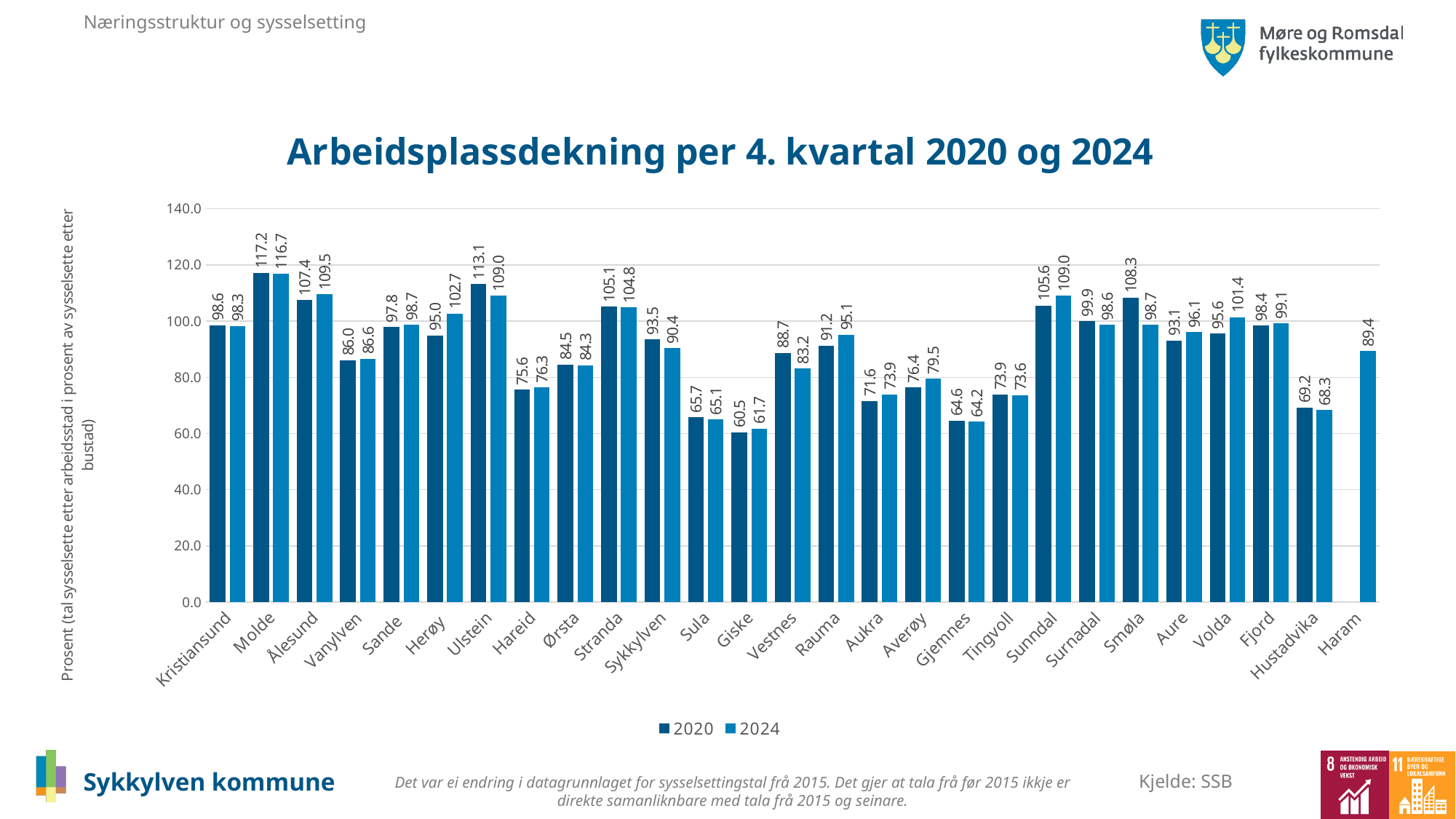
Which municipality has the highest value in 2020? Molde By how much did the value for Smøla fall from 2020 to 2024? 9.6 What type of chart is shown on the slide? Bar chart Which is larger for Volda: the 2020 value or the 2024 value? 2024 What is the difference between the 2024 and 2020 values for Herøy? 7.7 What is the value for Sykkylven in 2020? 93.5 What is the value for Herøy in 2024? 102.7 Which municipality has the lowest value in 2024? Giske How many municipalities are shown on the x axis? 27 Is the 2020 value for Ulstein greater or less than 100? greater What is the value for Haram in 2024? 89.4 How many series does the legend list? 2